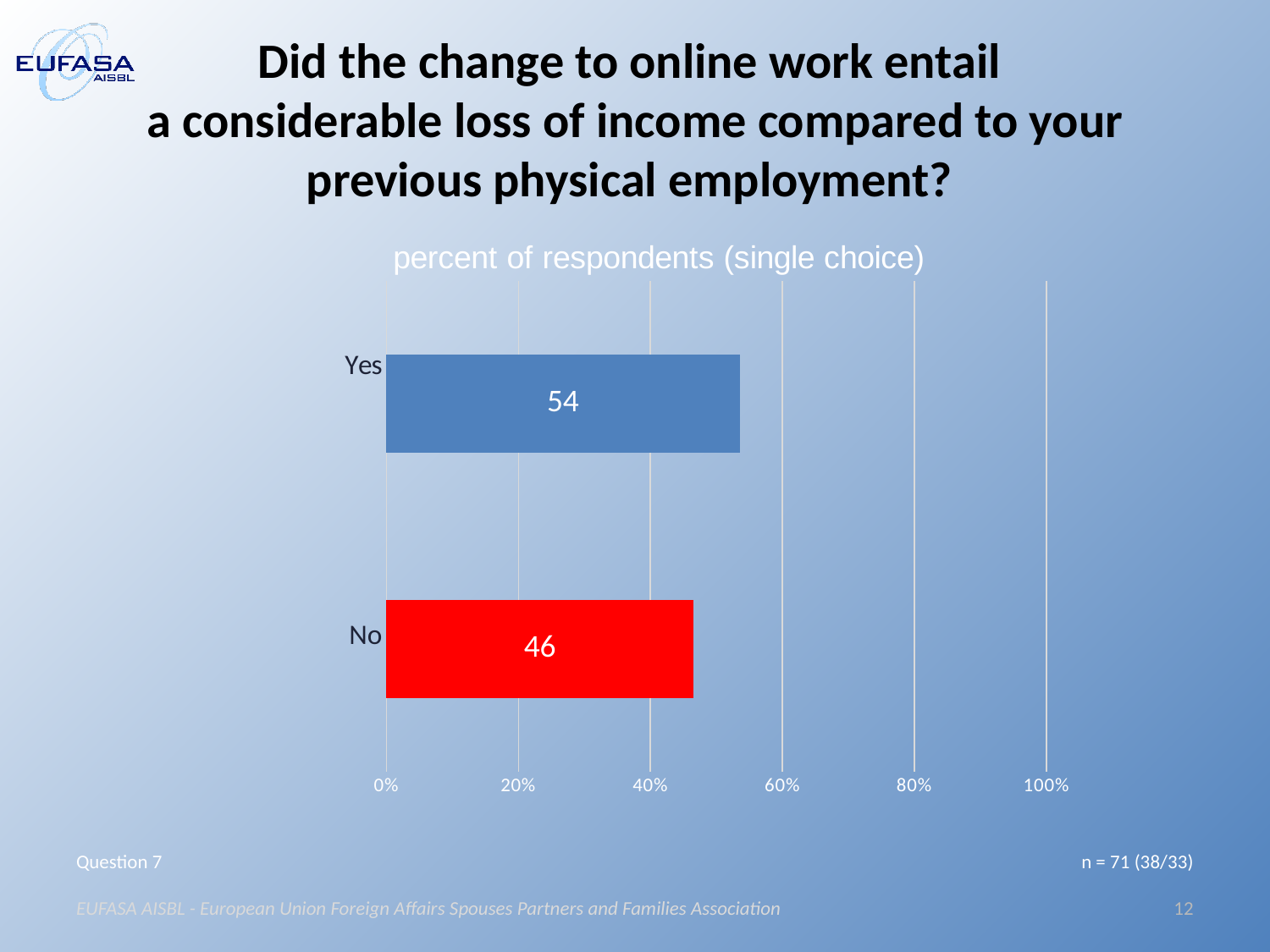
Which is larger, the value for Yes or the value for No? Yes What is the title of the chart? percent of respondents (single choice) Is the value for No greater or less than 60%? less What is the difference between the values for Yes and No? 8 Which category has the lowest value? No Which category has the highest value? Yes What is the value for Yes? 54 What colour is the bar for No? red What is the value for No? 46 What kind of chart is shown on the slide? bar chart How many categories are shown in the chart? 2 Is the value for Yes greater or less than 40%? greater